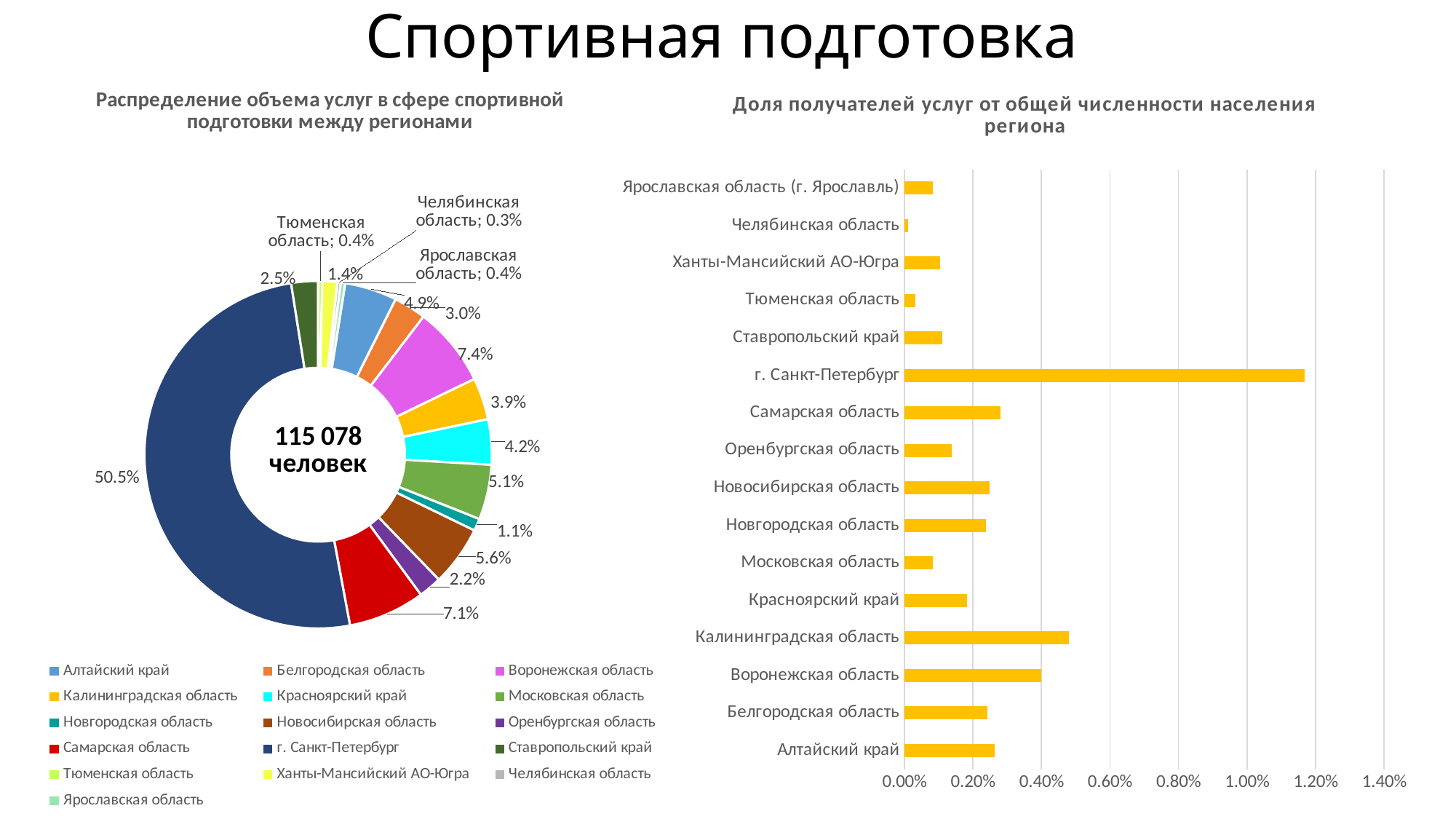
What kind of chart is 'Доля получателей услуг от общей численности населения региона'? Bar chart On the bar chart 'Доля получателей услуг от общей численности населения региона', which region has the highest value? г. Санкт-Петербург On the doughnut chart on the left, what share is shown for Самарская область? 7.1% On the doughnut chart 'Распределение объема услуг в сфере спортивной подготовки между регионами', what share does г. Санкт-Петербург have? 50.5% On the doughnut chart on the left, which has the larger share: Московская область or Красноярский край? Московская область On the doughnut chart on the left, what total number of people is shown in the centre? 115 078 человек On the doughnut chart on the left, what share is shown for Челябинская область? 0.3% On the bar chart 'Доля получателей услуг от общей численности населения региона', is the value for Калининградская область greater or less than 0.40%? greater On the doughnut chart on the left, what is the difference between the shares of Новосибирская область and Оренбургская область? 3.4% How many regions does the legend of the doughnut chart on the left list? 16 On the doughnut chart on the left, which region has the largest share? г. Санкт-Петербург On the doughnut chart on the left, what share is shown for Воронежская область? 7.4%